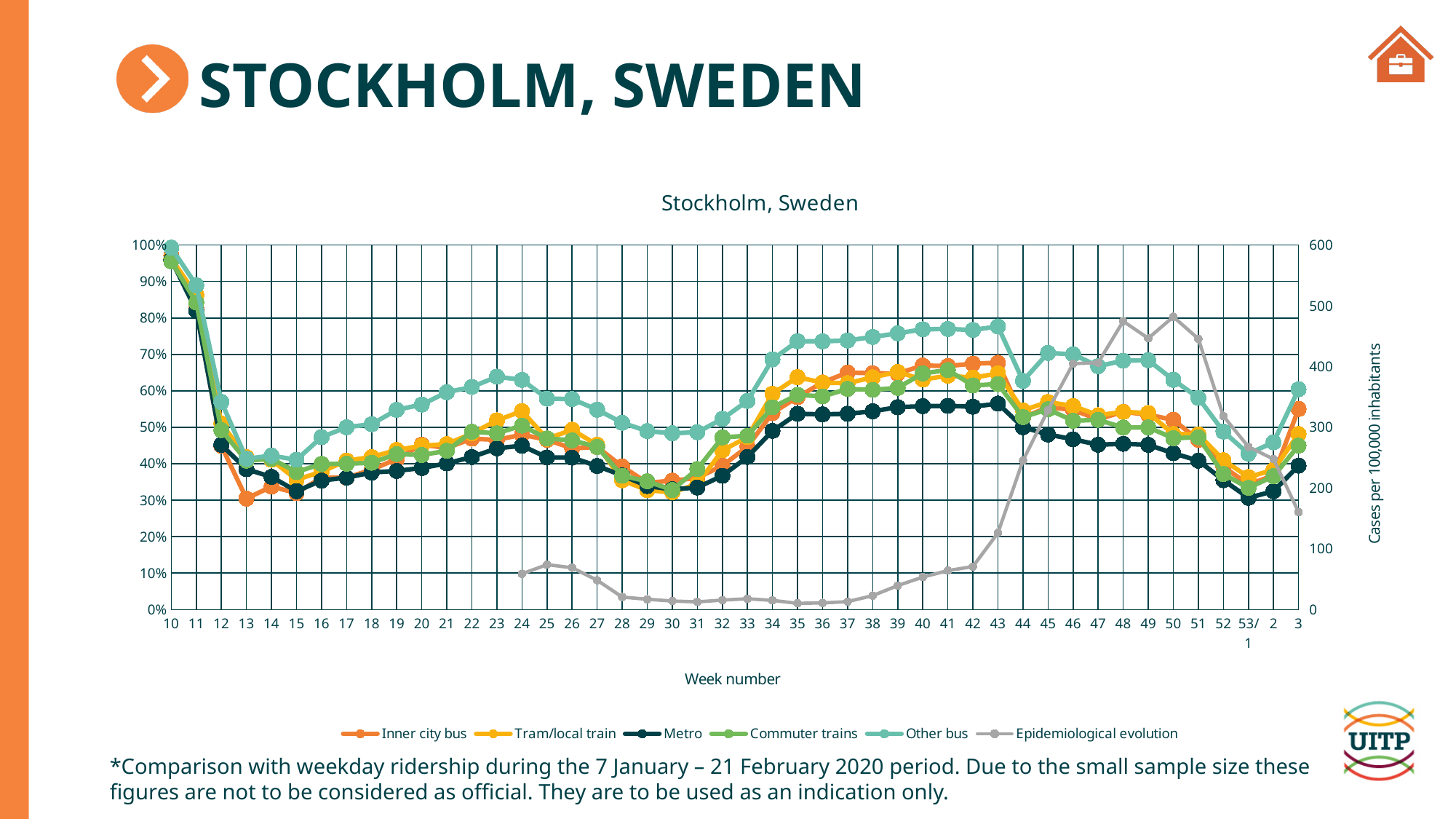
Is the value for Epidemiological evolution at week 36 greater or less than 100? less Is the value for Other bus at week 43 greater or less than 70%? greater Is the value for Inner city bus at week 13 greater or less than 40%? less What kind of chart is shown on the slide? Line chart What is the label of the horizontal axis? Week number Which ridership series has the lowest value at week 40? Metro What is the label of the right-hand vertical axis? Cases per 100,000 inhabitants Does the Other bus series rise or fall between week 34 and week 43? Rise Which ridership series has the highest value at week 43? Other bus How many series does the legend list? 6